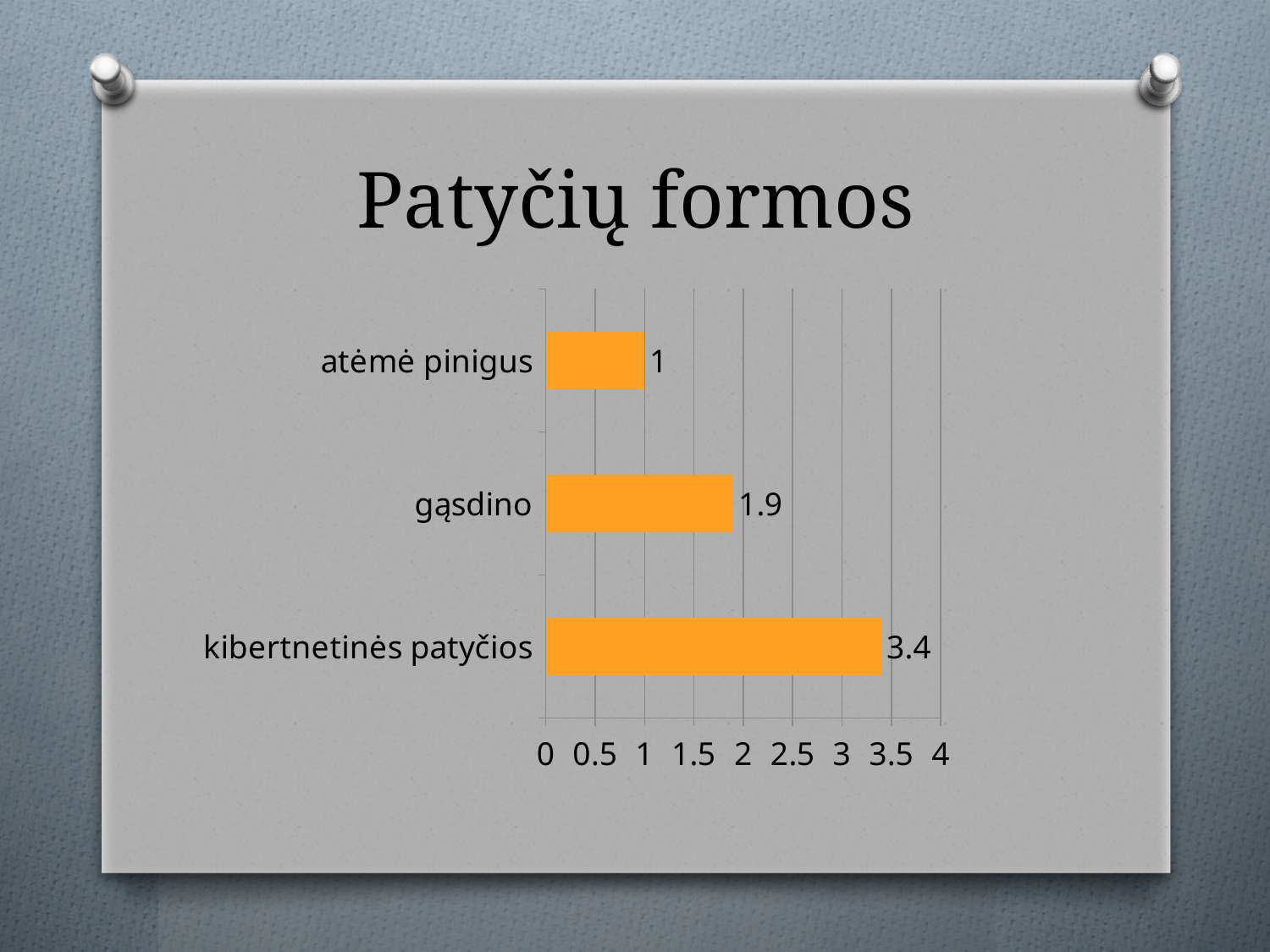
Which is larger, the value for "gąsdino" or the value for "atėmė pinigus"? gąsdino Is the value for "kibertnetinės patyčios" greater or less than 3? greater Which category has the highest value? kibertnetinės patyčios What is the value for "kibertnetinės patyčios"? 3.4 What is the value for "gąsdino"? 1.9 How many categories are shown in the chart? 3 What is the title of the slide? Patyčių formos What is the value for "atėmė pinigus"? 1 What is the difference between the values for "gąsdino" and "atėmė pinigus"? 0.9 What kind of chart is shown on the slide? bar chart What is the difference between the values for "kibertnetinės patyčios" and "gąsdino"? 1.5 Which category has the lowest value? atėmė pinigus